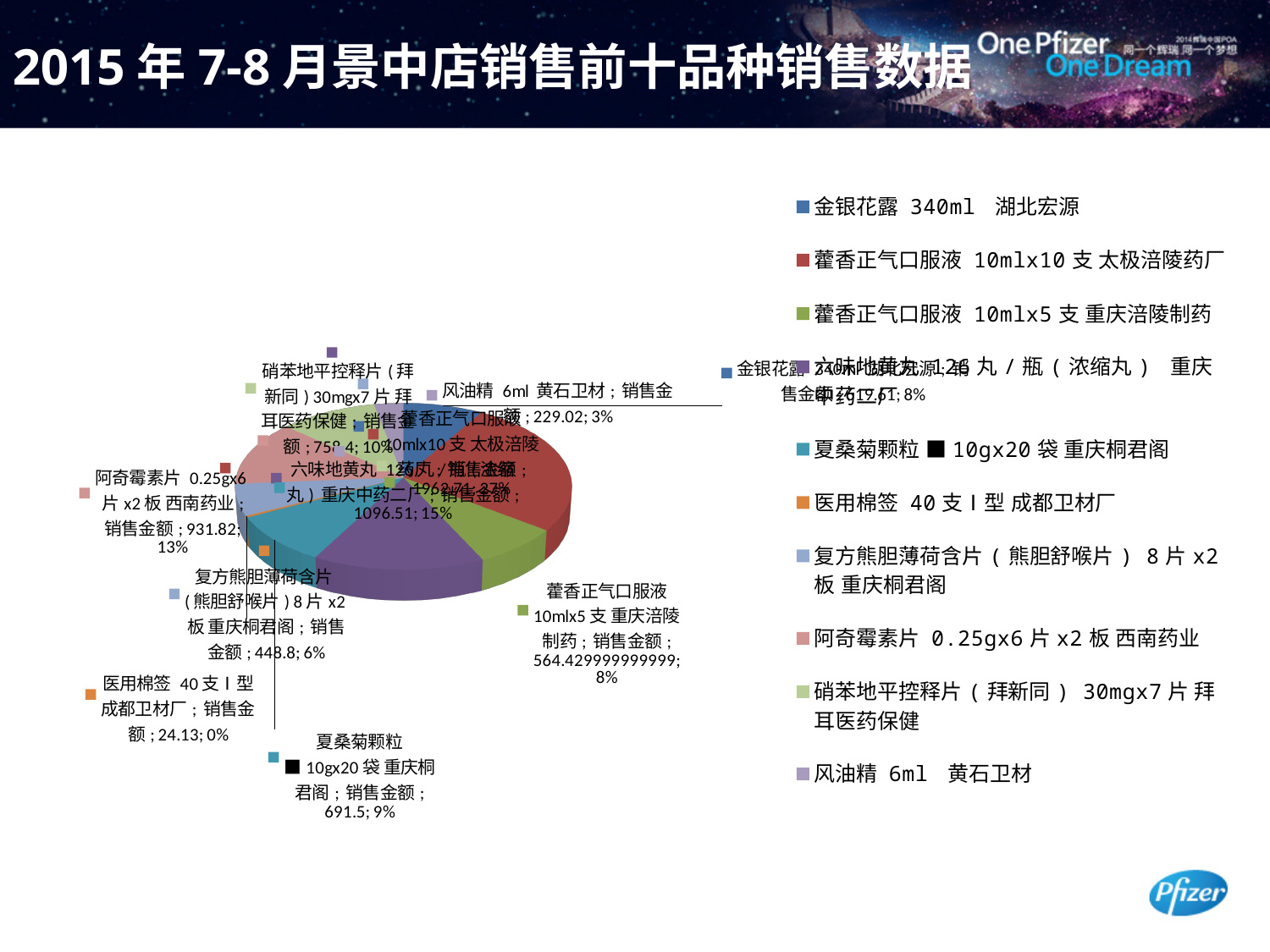
What is the 销售金额 value for 阿奇霉素片 0.25gx6 片 x2 板 西南药业? 931.82 What is the 销售金额 value for 风油精 6ml 黄石卫材? 229.02 What is the 销售金额 value for 医用棉签 40 支 I 型 成都卫材厂? 24.13 What is the 销售金额 value for 夏桑菊颗粒 10gx20 袋 重庆桐君阁? 691.5 How many entries does the legend list? 10 Which product has the smallest slice in the pie chart? 医用棉签 40 支 I 型 成都卫材厂 How many slices does the pie chart have? 10 What share of the pie does 夏桑菊颗粒 10gx20 袋 重庆桐君阁 represent? 9% What is the difference between the 销售金额 for 阿奇霉素片 0.25gx6 片 x2 板 西南药业 and for 夏桑菊颗粒 10gx20 袋 重庆桐君阁? 240.32 What kind of chart is shown on the slide? pie chart Which is larger, the 销售金额 for 阿奇霉素片 0.25gx6 片 x2 板 西南药业 or for 夏桑菊颗粒 10gx20 袋 重庆桐君阁? 阿奇霉素片 0.25gx6 片 x2 板 西南药业 What is the 销售金额 value for 复方熊胆薄荷含片 (熊胆舒喉片) 8 片 x2 板 重庆桐君阁? 448.8